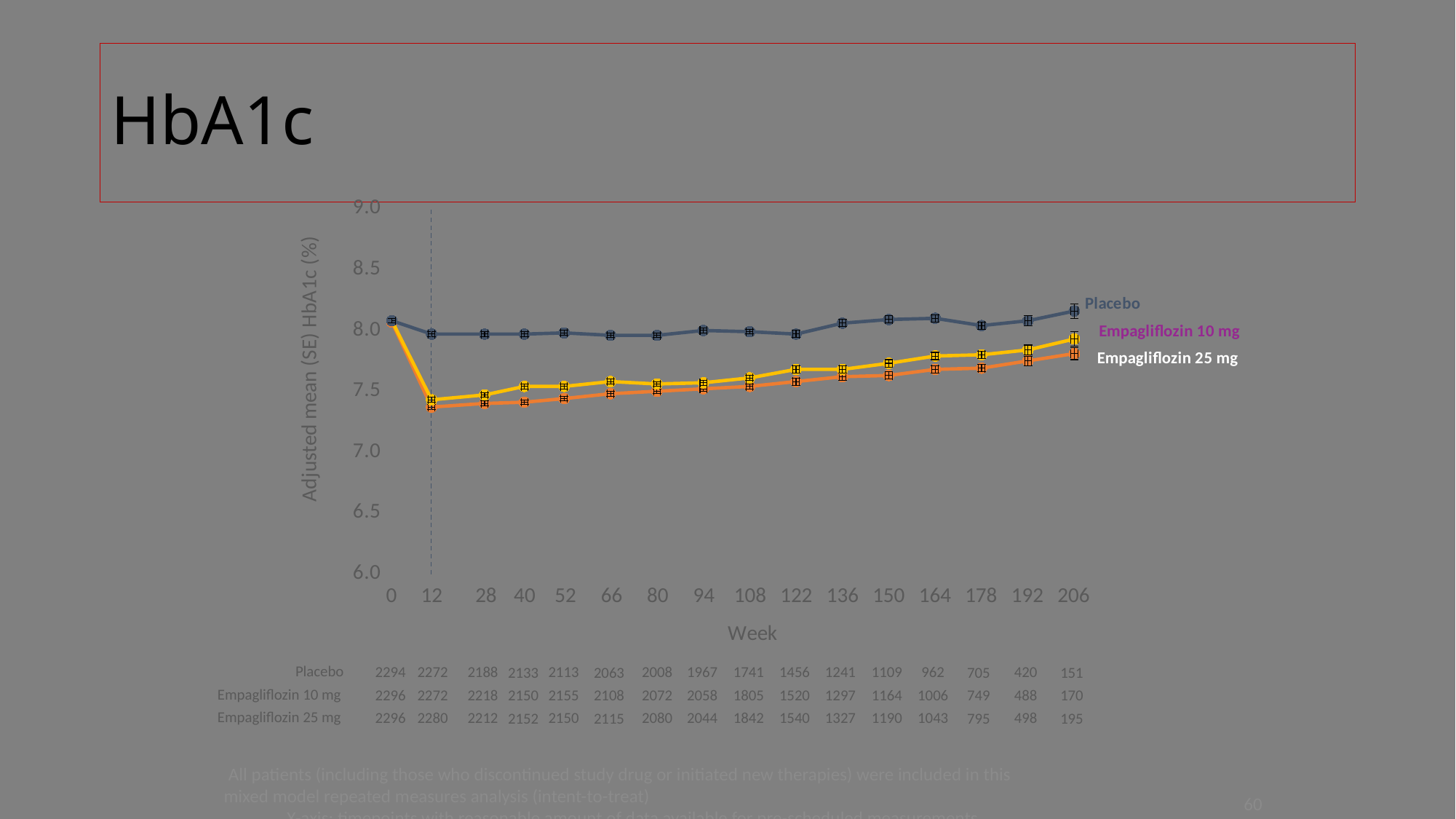
Is the Empagliflozin 25 mg value at week 12 greater or less than 7.5? less Is the Placebo value at week 206 greater or less than 8.0? greater How many series are plotted in the HbA1c chart? 3 What is the label of the y axis of the chart? Adjusted mean (SE) HbA1c (%) Does the Empagliflozin 10 mg line rise or fall from week 12 to week 206? rise According to the table below the chart, how many Placebo patients are listed at week 206? 151 Which group has the lowest adjusted mean HbA1c at week 164? Empagliflozin 25 mg What kind of chart is shown on the slide? line chart How many week timepoints are shown on the x axis of the chart? 16 At week 206, which is higher: Placebo or Empagliflozin 25 mg? Placebo Which group has the highest adjusted mean HbA1c at week 108? Placebo According to the table below the chart, how many Empagliflozin 25 mg patients are listed at week 0? 2296